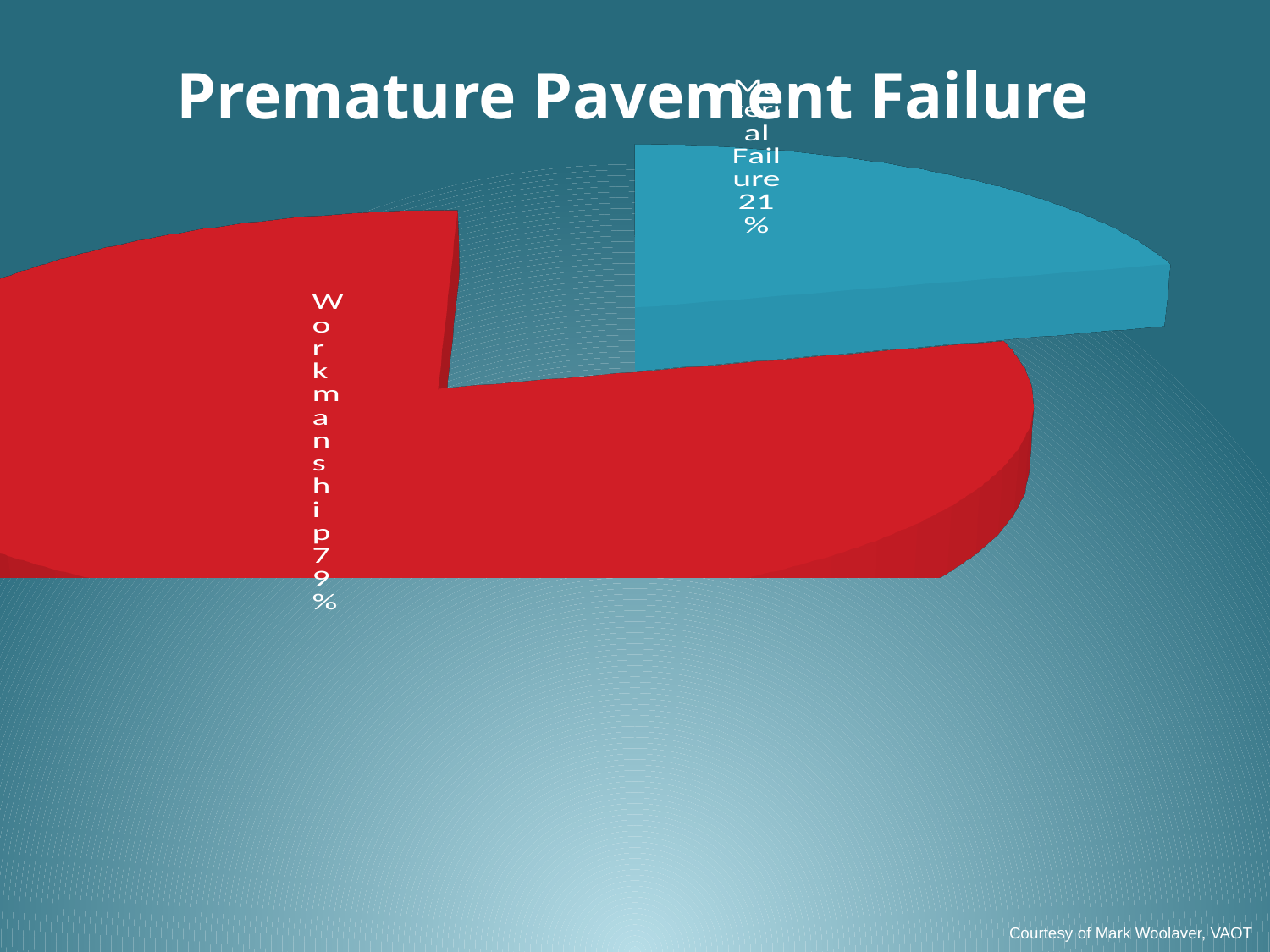
What do the two slices of the pie chart add up to? 100% How many slices does the pie chart have? 2 What kind of chart is shown on the slide? pie chart What is the title of the chart on the slide? Premature Pavement Failure Which category accounts for the largest share of premature pavement failure? Workmanship By how many percentage points does the Workmanship share exceed the Material Failure share? 58 percentage points What colour is the Workmanship slice of the pie chart? red Which is larger, the share for Workmanship or the share for Material Failure? Workmanship What share of the pie does the Workmanship slice represent? 79% Which category accounts for the smallest share of premature pavement failure? Material Failure What percentage of premature pavement failure is attributed to Workmanship? 79% What percentage of premature pavement failure is attributed to Material Failure? 21%